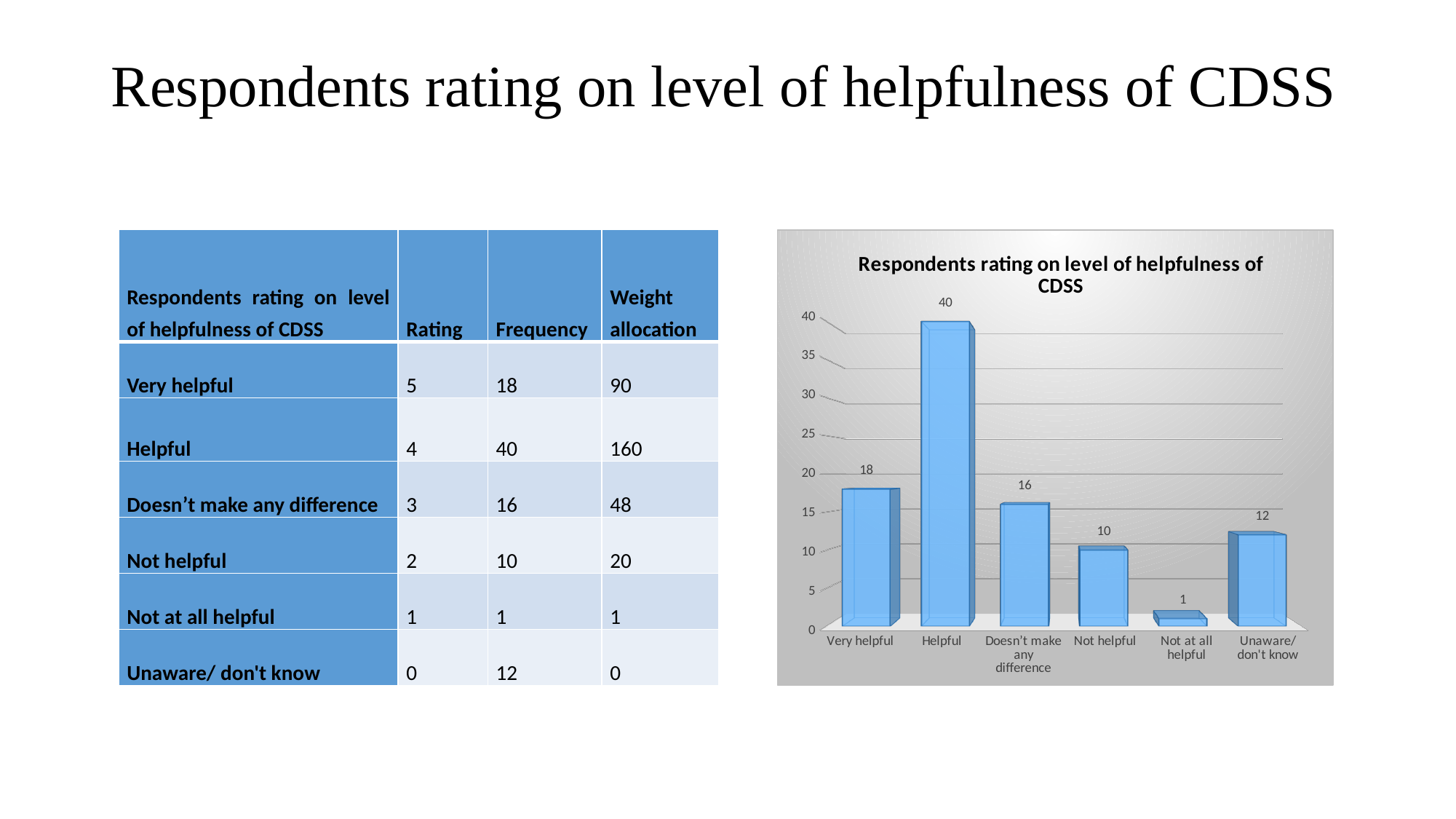
What is the title of the chart? Respondents rating on level of helpfulness of CDSS Which is larger, the value for Very helpful or the value for Unaware/ don't know? Very helpful What is the difference between the values for Doesn't make any difference and Not helpful? 6 How many categories are shown on the x axis of the chart? 6 What is the value for Not at all helpful in the chart? 1 What is the value for Very helpful in the chart? 18 What is the value for Helpful in the chart? 40 What kind of chart is shown on the slide? Bar chart What is the value for Unaware/ don't know in the chart? 12 Which category has the highest value in the chart? Helpful Which category has the lowest value in the chart? Not at all helpful What is the difference between the values for Helpful and Very helpful? 22